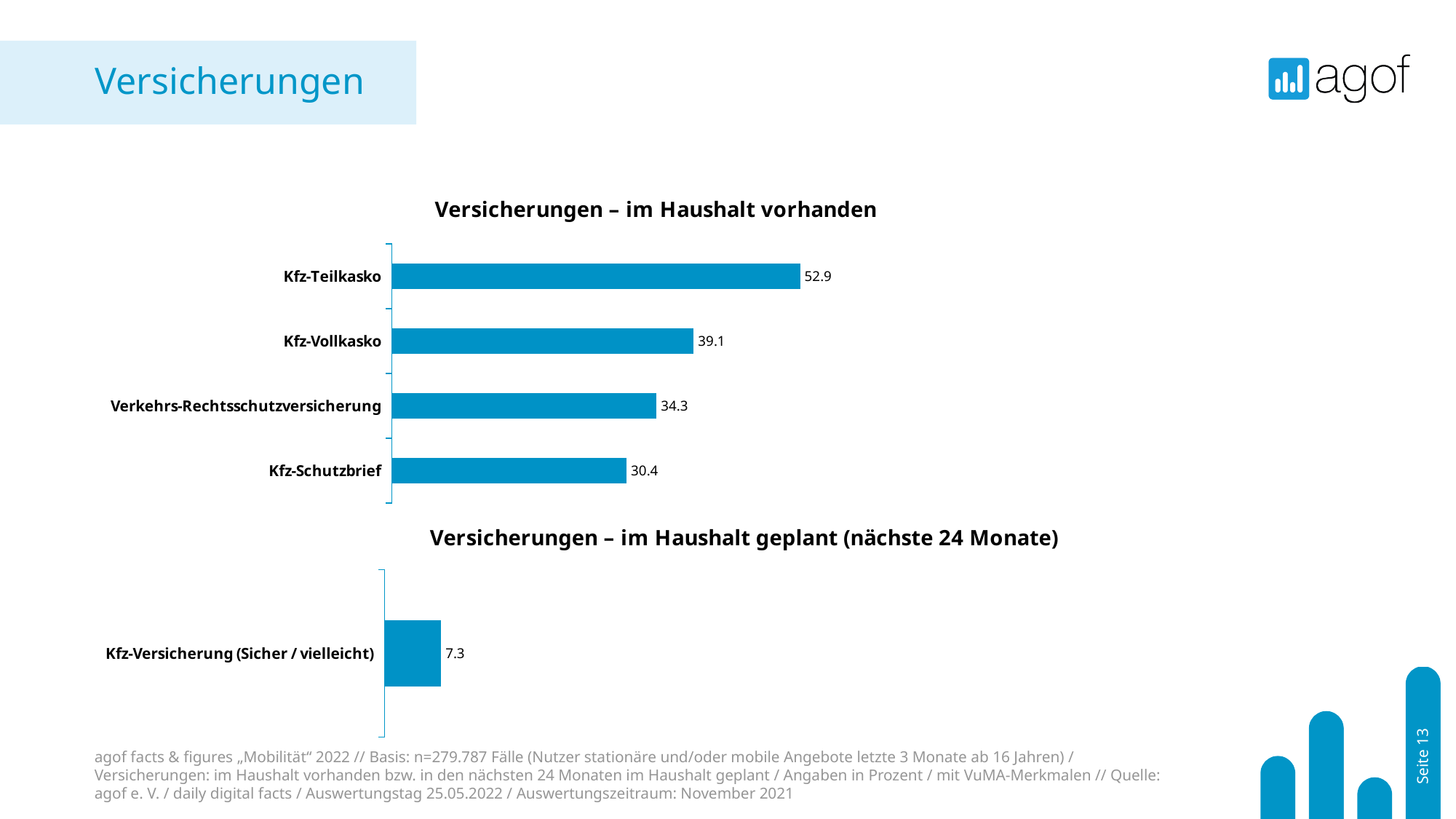
In the chart 'Versicherungen – im Haushalt vorhanden', what is the difference between Kfz-Teilkasko and Kfz-Vollkasko? 13.8 In the chart 'Versicherungen – im Haushalt vorhanden', which category has the highest value? Kfz-Teilkasko In the chart 'Versicherungen – im Haushalt vorhanden', what is the value for Kfz-Schutzbrief? 30.4 In the chart 'Versicherungen – im Haushalt vorhanden', which category has the lowest value? Kfz-Schutzbrief What kind of chart is 'Versicherungen – im Haushalt vorhanden'? Bar chart In the chart 'Versicherungen – im Haushalt vorhanden', which is larger: Kfz-Vollkasko or Verkehrs-Rechtsschutzversicherung? Kfz-Vollkasko In the chart 'Versicherungen – im Haushalt geplant (nächste 24 Monate)', what is the value for Kfz-Versicherung (Sicher / vielleicht)? 7.3 In the chart 'Versicherungen – im Haushalt vorhanden', what is the value for Kfz-Teilkasko? 52.9 How many categories are shown in the chart 'Versicherungen – im Haushalt geplant (nächste 24 Monate)'? 1 In the chart 'Versicherungen – im Haushalt vorhanden', what is the value for Verkehrs-Rechtsschutzversicherung? 34.3 What is the title of the lower chart on the slide? Versicherungen – im Haushalt geplant (nächste 24 Monate) How many categories are shown in the chart 'Versicherungen – im Haushalt vorhanden'? 4